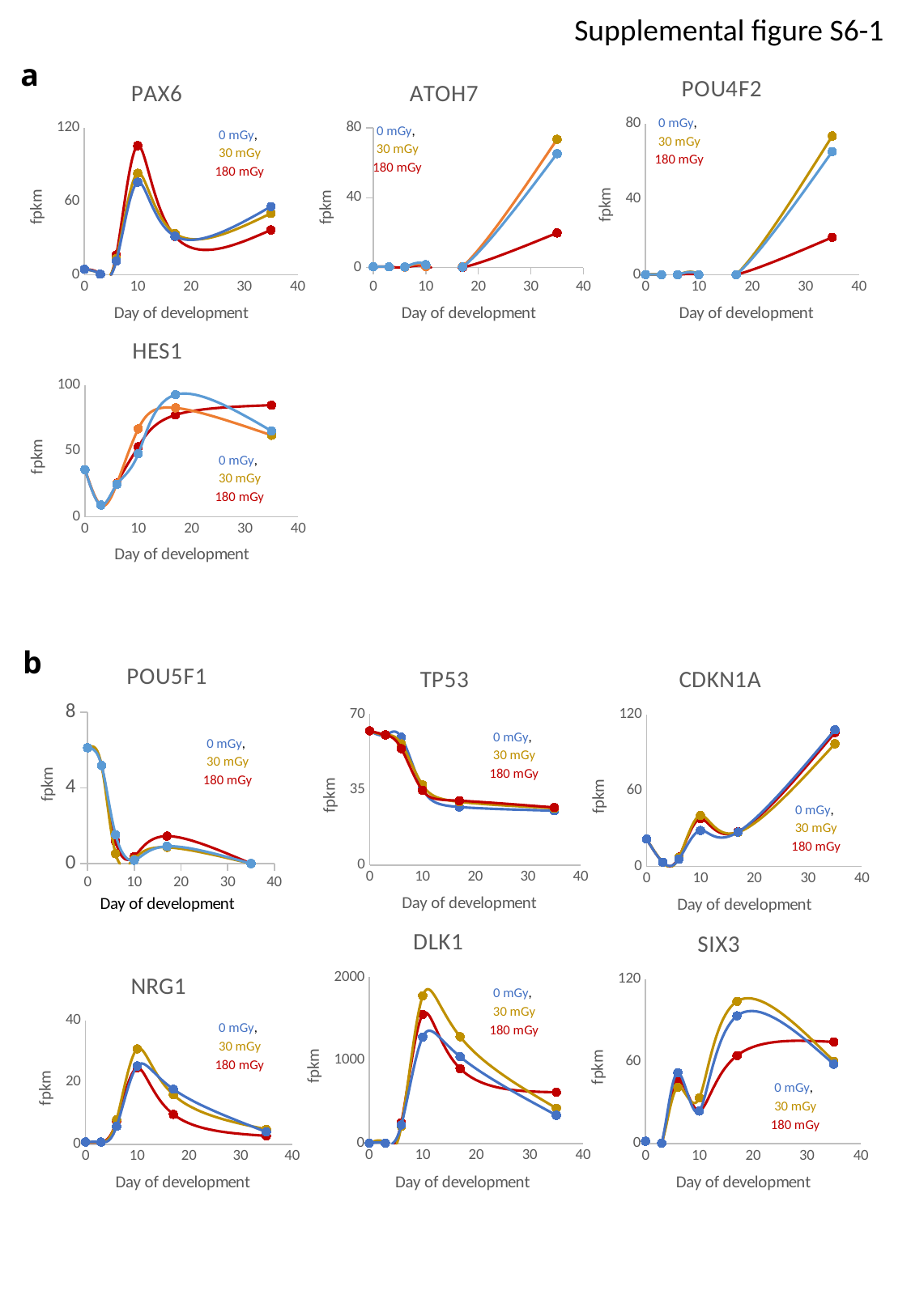
In the ATOH7 chart, is the value for 180 mGy at day 35 greater or less than 40? less How many series does the legend of the ATOH7 chart list? 3 In the PAX6 chart, is the value for 180 mGy at day 10 greater or less than 60? greater What is the y-axis label on the SIX3 chart? fpkm In the NRG1 chart, is the value for 180 mGy at day 35 greater or less than 20? less What kind of chart is the PAX6 chart? line chart In the ATOH7 chart, which is larger at day 35: the value for 30 mGy or the value for 180 mGy? 30 mGy In the TP53 chart, do the values rise or fall along the x axis from day 0 to day 35? fall How many charts are shown in panel b of the slide? 6 In the CDKN1A chart, do the values rise or fall between day 17 and day 35? rise